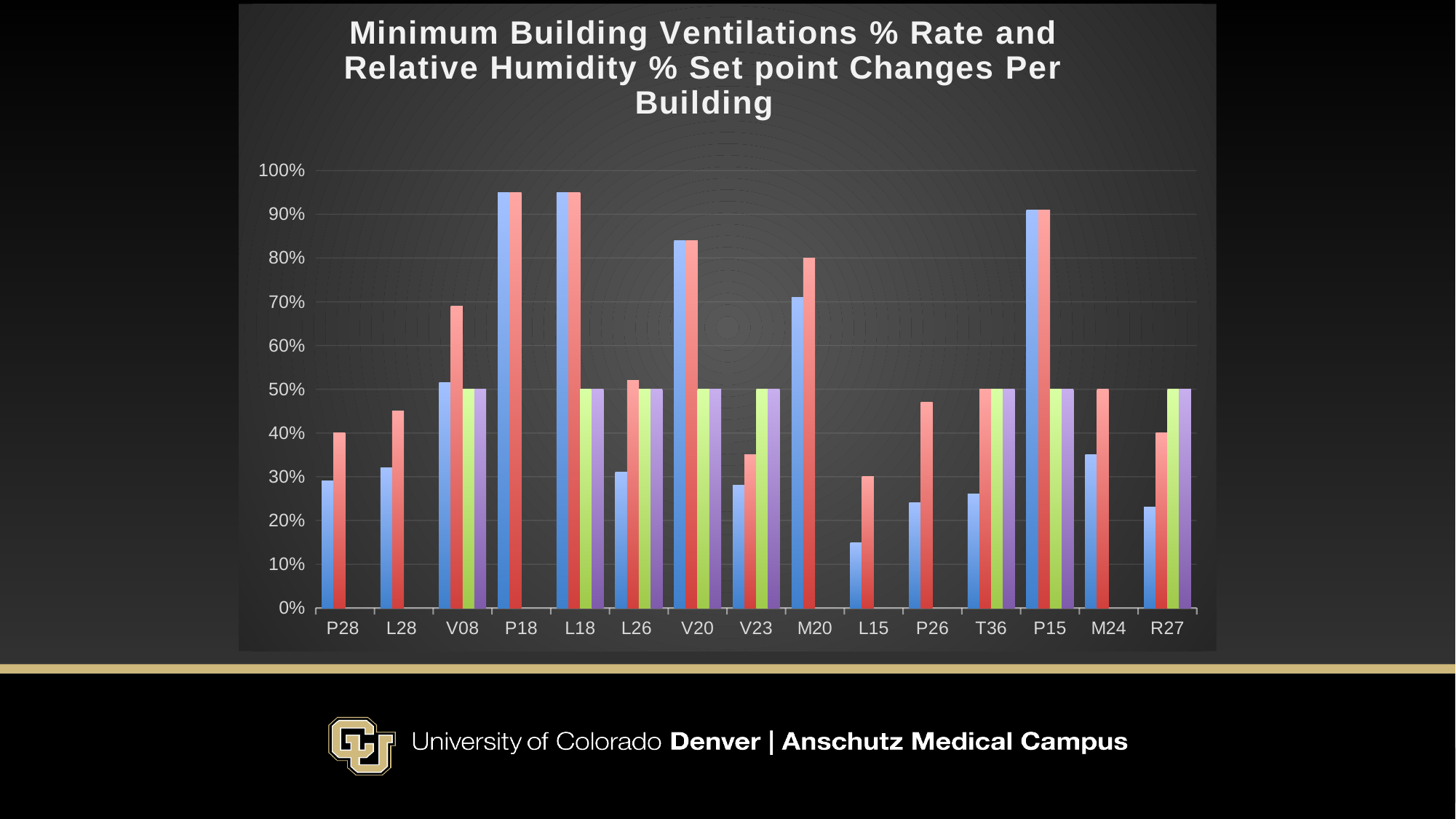
Is the value of the red bar for P26 greater or less than 50%? less What kind of chart is shown on the slide? bar chart What is the title of the chart? Minimum Building Ventilations % Rate and Relative Humidity % Set point Changes Per Building Is the value of the blue bar for V20 greater or less than 80%? greater Which building has the lowest blue bar? L15 How many bars are plotted for building P28? 2 How many buildings are listed along the x axis of the chart? 15 Which is larger, the red bar for V08 or the red bar for L26? V08 Which is larger, the blue bar for V20 or the blue bar for M20? V20 Is the value of the blue bar for L15 greater or less than 20%? less